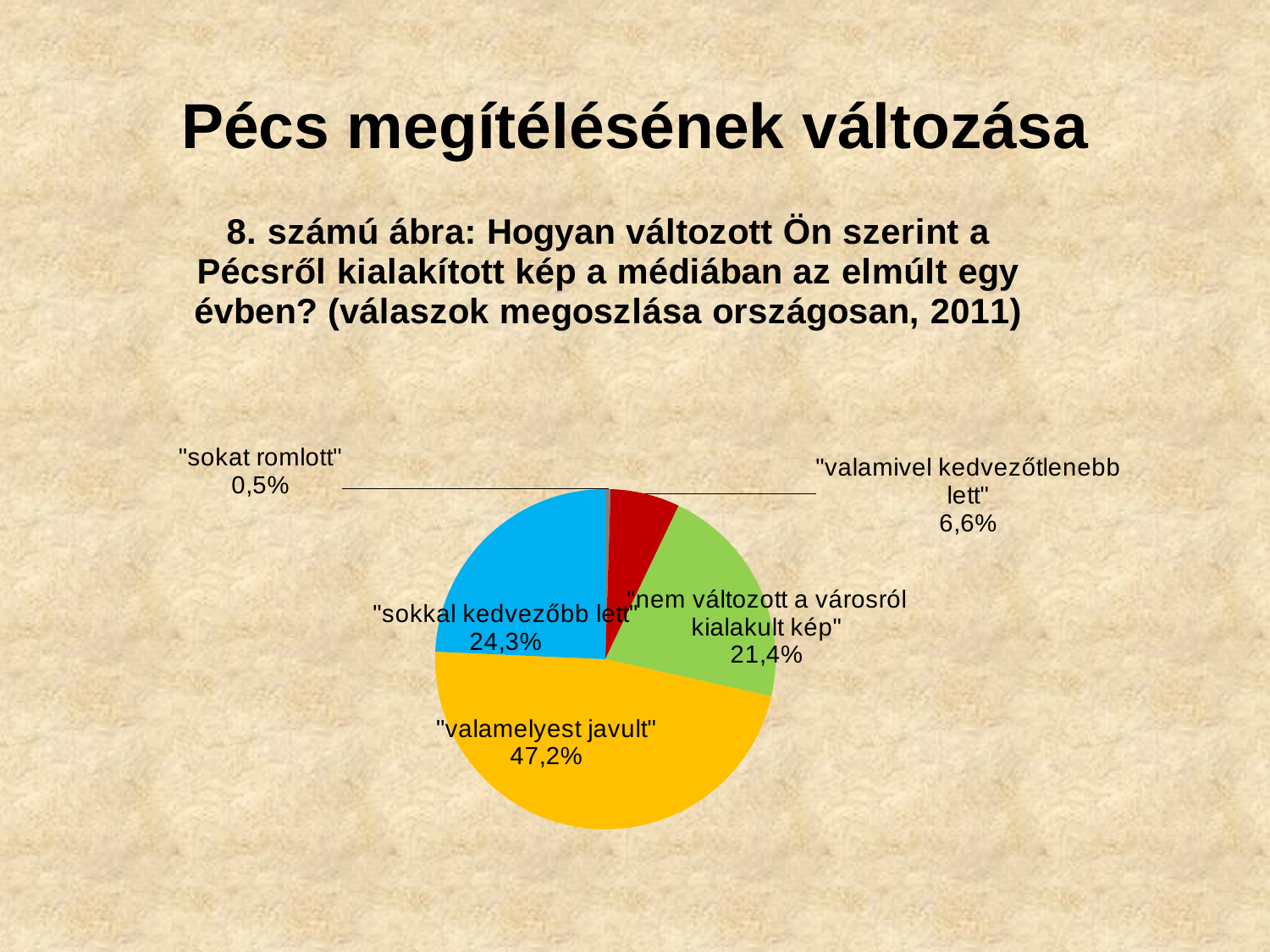
What share of responses is "sokat romlott"? 0,5% What kind of chart is shown on the slide? pie chart Which is larger: the share for "sokkal kedvezőbb lett" or for "nem változott a városról kialakult kép"? "sokkal kedvezőbb lett" What share of responses is "sokkal kedvezőbb lett"? 24,3% Which response category has the smallest share of the pie? "sokat romlott" What share of responses is "valamivel kedvezőtlenebb lett"? 6,6% What colour is the slice for "valamelyest javult"? yellow What is the difference in percentage points between "valamelyest javult" and "sokkal kedvezőbb lett"? 22,9 How many slices does the pie chart have? 5 What share of responses is "valamelyest javult"? 47,2% What share of responses is "nem változott a városról kialakult kép"? 21,4% Which response category has the largest share of the pie? "valamelyest javult"